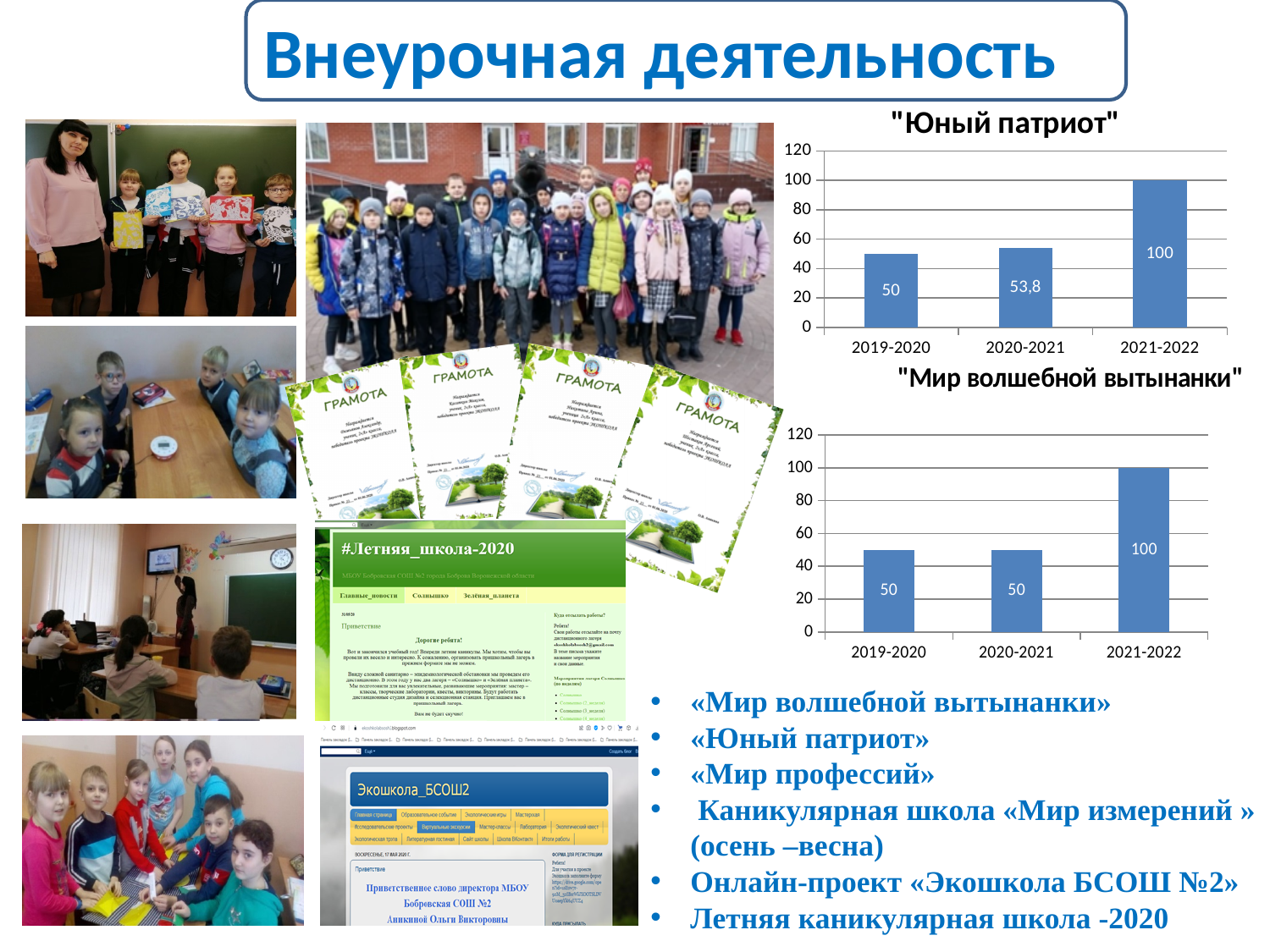
In the "Юный патриот" chart, what is the difference between the values for 2021-2022 and 2019-2020? 50 What kind of chart is the "Юный патриот" chart? Bar chart In the "Юный патриот" chart, what is the value for 2021-2022? 100 In the "Мир волшебной вытынанки" chart, what is the value for 2019-2020? 50 In the "Юный патриот" chart, which is larger: the value for 2020-2021 or the value for 2019-2020? 2020-2021 In the "Мир волшебной вытынанки" chart, which category has the highest value? 2021-2022 How many categories are shown in the "Мир волшебной вытынанки" chart? 3 In the "Юный патриот" chart, which category has the highest value? 2021-2022 In the "Мир волшебной вытынанки" chart, what is the difference between the values for 2021-2022 and 2020-2021? 50 In the "Юный патриот" chart, what is the value for 2020-2021? 53,8 In the "Мир волшебной вытынанки" chart, do the values rise or fall from 2020-2021 to 2021-2022? Rise In the "Юный патриот" chart, which category has the lowest value? 2019-2020